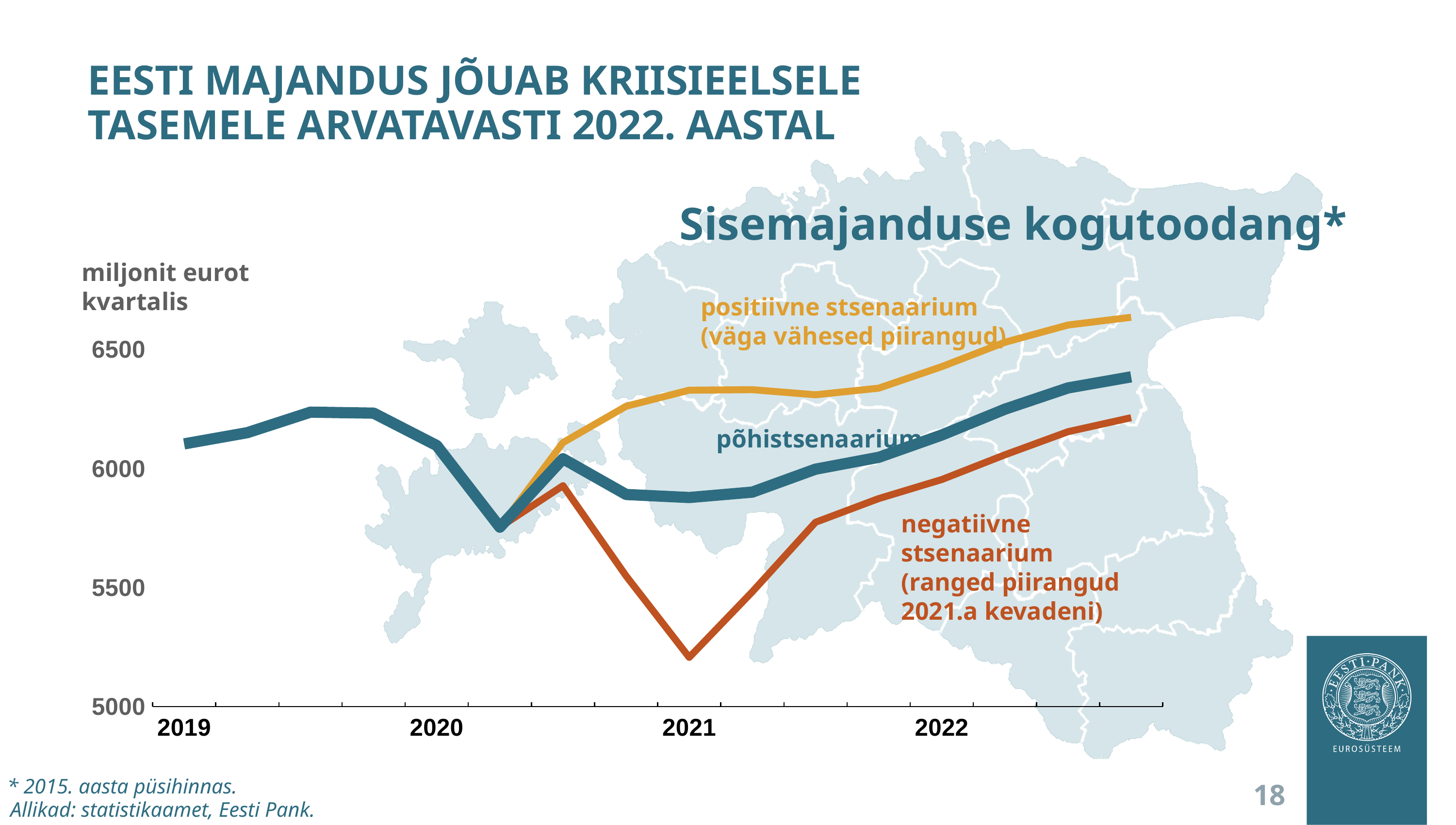
What unit is shown for the y axis of the chart? miljonit eurot kvartalis What is the title of the chart? Sisemajanduse kogutoodang* Does the põhistsenaarium line rise or fall from 2021 to the end of 2022? rise Which scenario line is highest at the end of 2022? positiivne stsenaarium How many scenario lines are plotted on the chart? 3 Which scenario line reaches the lowest value on the chart? negatiivne stsenaarium Is the value of the negatiivne stsenaarium line at the end of 2022 greater or less than 6000? greater Is the value of the positiivne stsenaarium line at the end of 2022 greater or less than 6500? greater Is the value of the põhistsenaarium line at the end of 2022 greater or less than 6500? less What kind of chart is shown on the slide? line chart At the end of 2022, which is higher: the põhistsenaarium line or the negatiivne stsenaarium line? põhistsenaarium